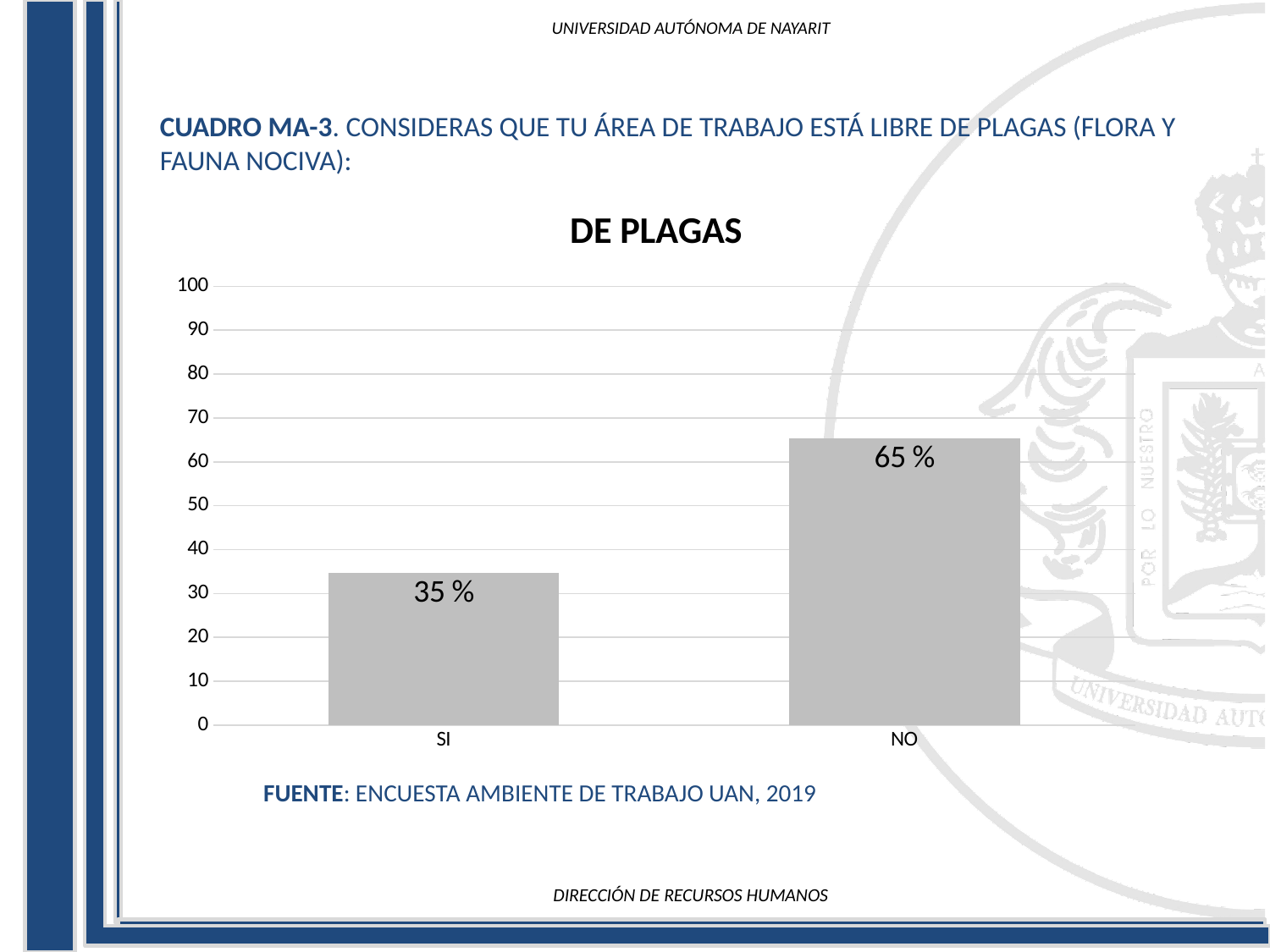
Is the value for SI greater or less than 40? less Which category has the lowest value? SI What is the value for NO? 65 % What is the value for SI? 35 % Which is larger, the value for SI or the value for NO? NO What is the highest value shown on the y axis? 100 How many categories are shown on the x axis? 2 Is the value for NO greater or less than 50? greater What is the title of the chart? DE PLAGAS What kind of chart is shown on the slide? bar chart Which category has the highest value? NO What is the difference between the values for NO and SI? 30 %